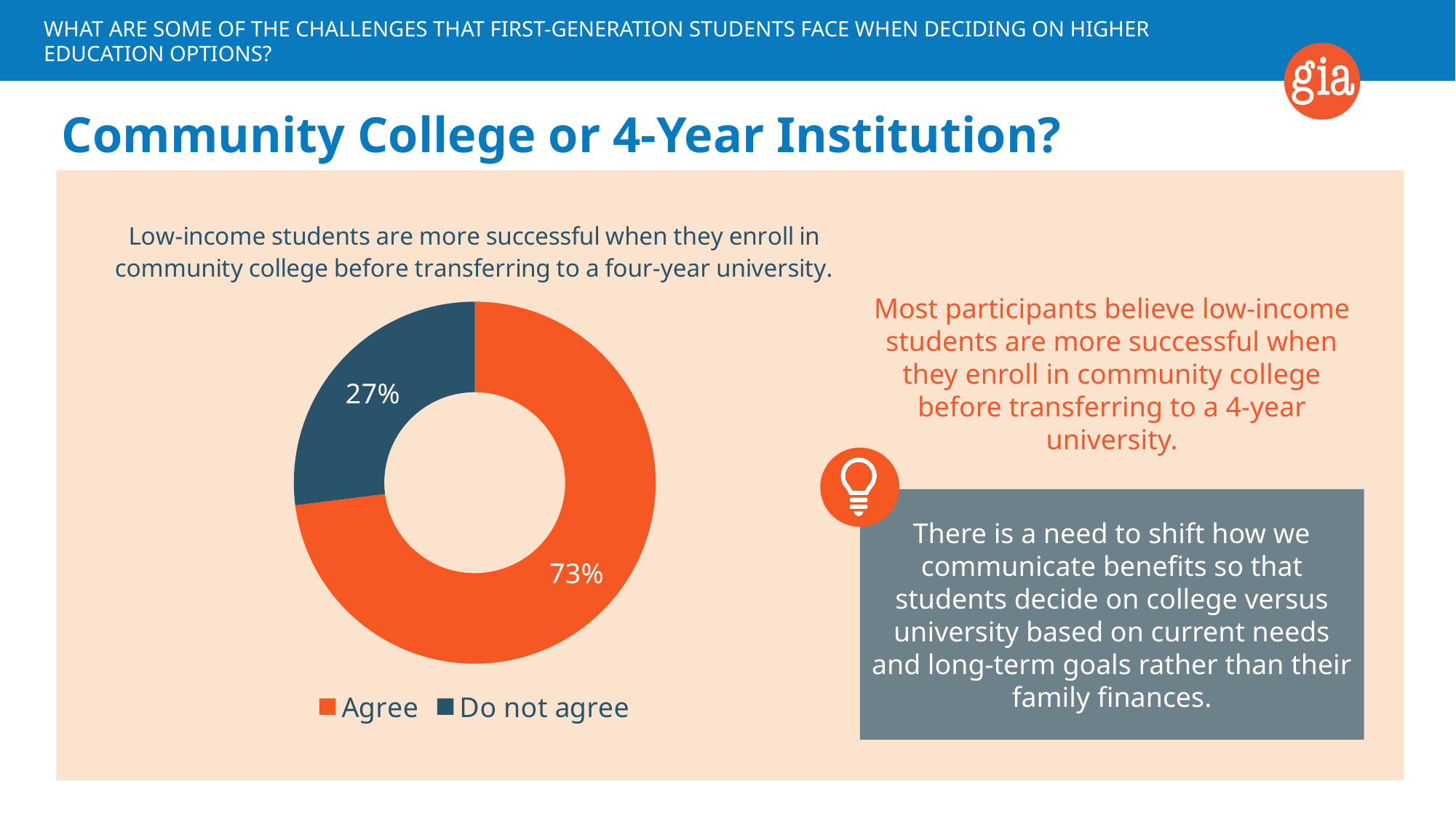
What colour is the Do not agree slice? Dark blue Which response has the larger share of the pie: Agree or Do not agree? Agree What statement is the chart's title asking participants to respond to? Low-income students are more successful when they enroll in community college before transferring to a four-year university. What percentage of participants do not agree with the statement in the chart? 27% How many categories does the chart show? 2 How many entries does the legend list? 2 Which response has the smallest share of the pie? Do not agree What percentage of participants agree that low-income students are more successful when they enroll in community college before transferring to a four-year university? 73% What is the difference in percentage points between the Agree and Do not agree shares? 46 Is the share for Agree larger or smaller than the share for Do not agree? Larger What share of the pie does the Agree slice represent? 73% What kind of chart is shown on the slide? Pie chart (doughnut)